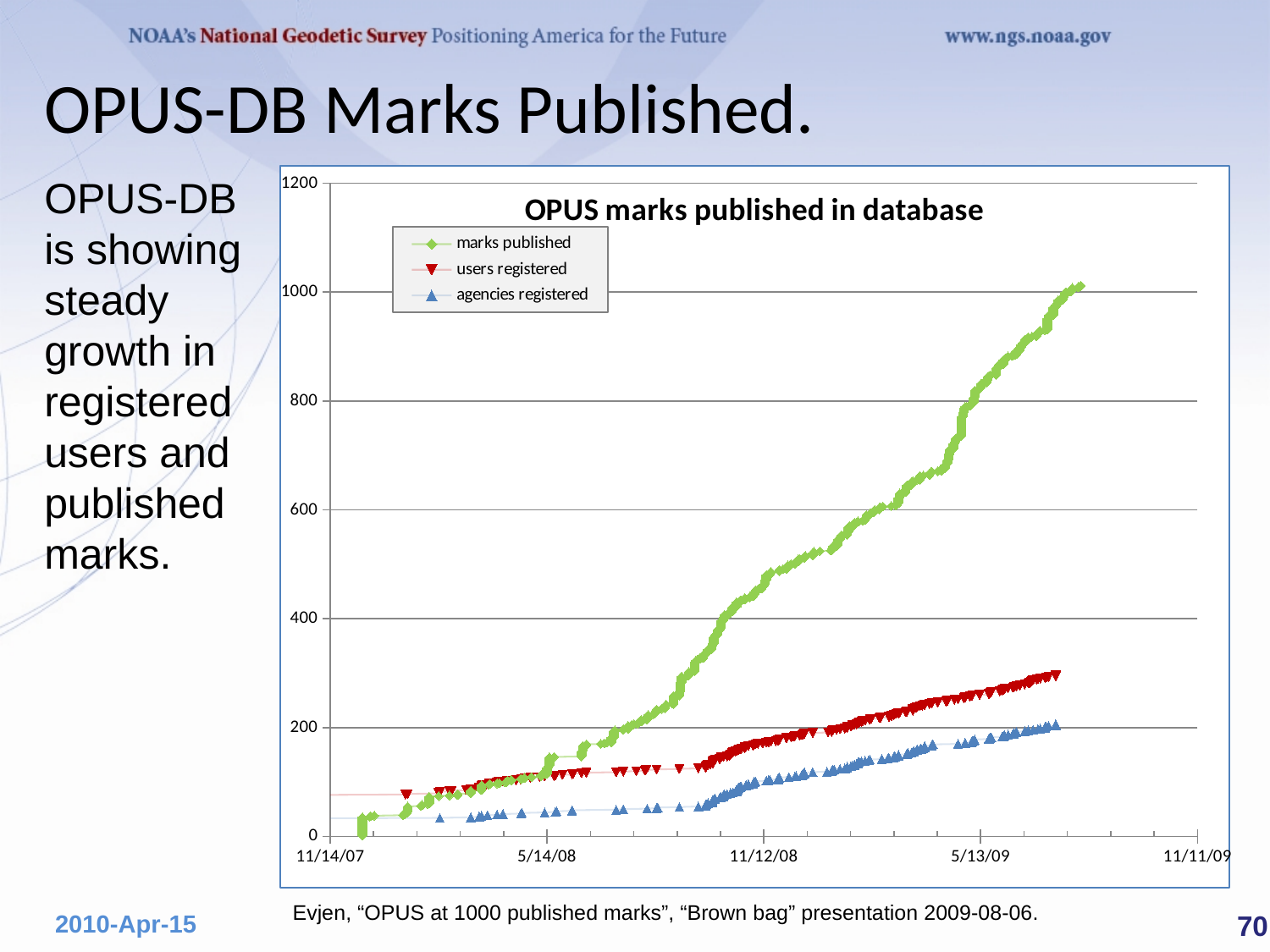
Which series stays lowest across the chart? agencies registered Is the value of the agencies registered series at 11/12/08 greater or less than 200? less Is the value of the marks published series at 11/12/08 greater or less than 200? greater At the end of the plotted period, which is larger: users registered or agencies registered? users registered Which series reaches the highest value on the chart? marks published Is the final value of the users registered series greater or less than 400? less How many series does the chart legend list? 3 Which series is drawn in green on the chart? marks published Does the marks published series rise or fall over time along the x axis? rise What is the title of the chart? OPUS marks published in database What kind of chart is shown on the slide? line chart